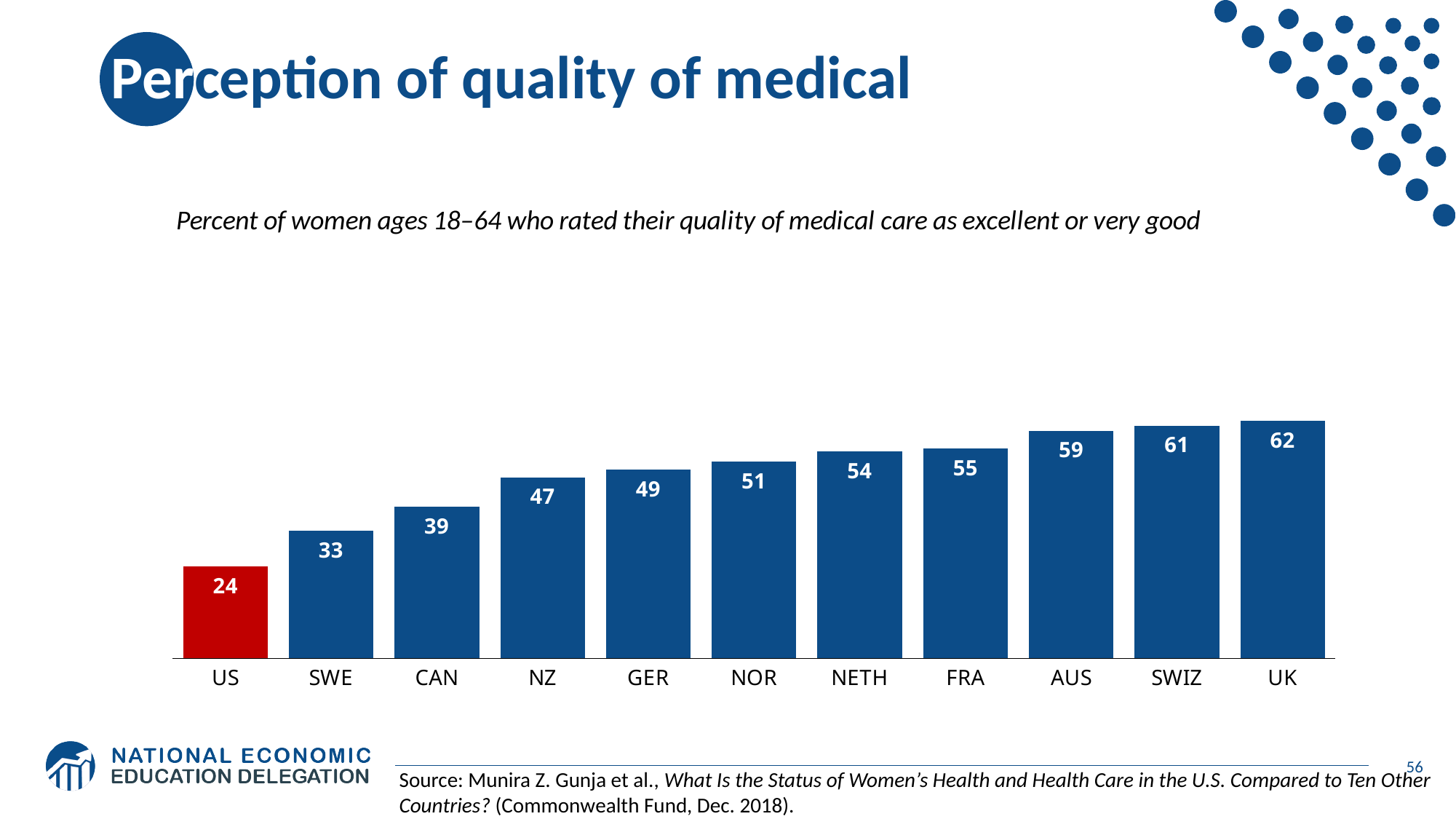
Do the values rise or fall from left to right along the x axis? Rise What is the value for AUS? 59 Which has a larger value, SWE or NZ? NZ Which country's bar is coloured red rather than blue? US How many countries are shown in the chart? 11 Which country has the highest value? UK Which country has the lowest value? US What is the value for the US? 24 What is the difference between the values for NETH and CAN? 15 What is the value for GER? 49 What kind of chart is shown on the slide? Bar chart What is the difference between the values for UK and US? 38